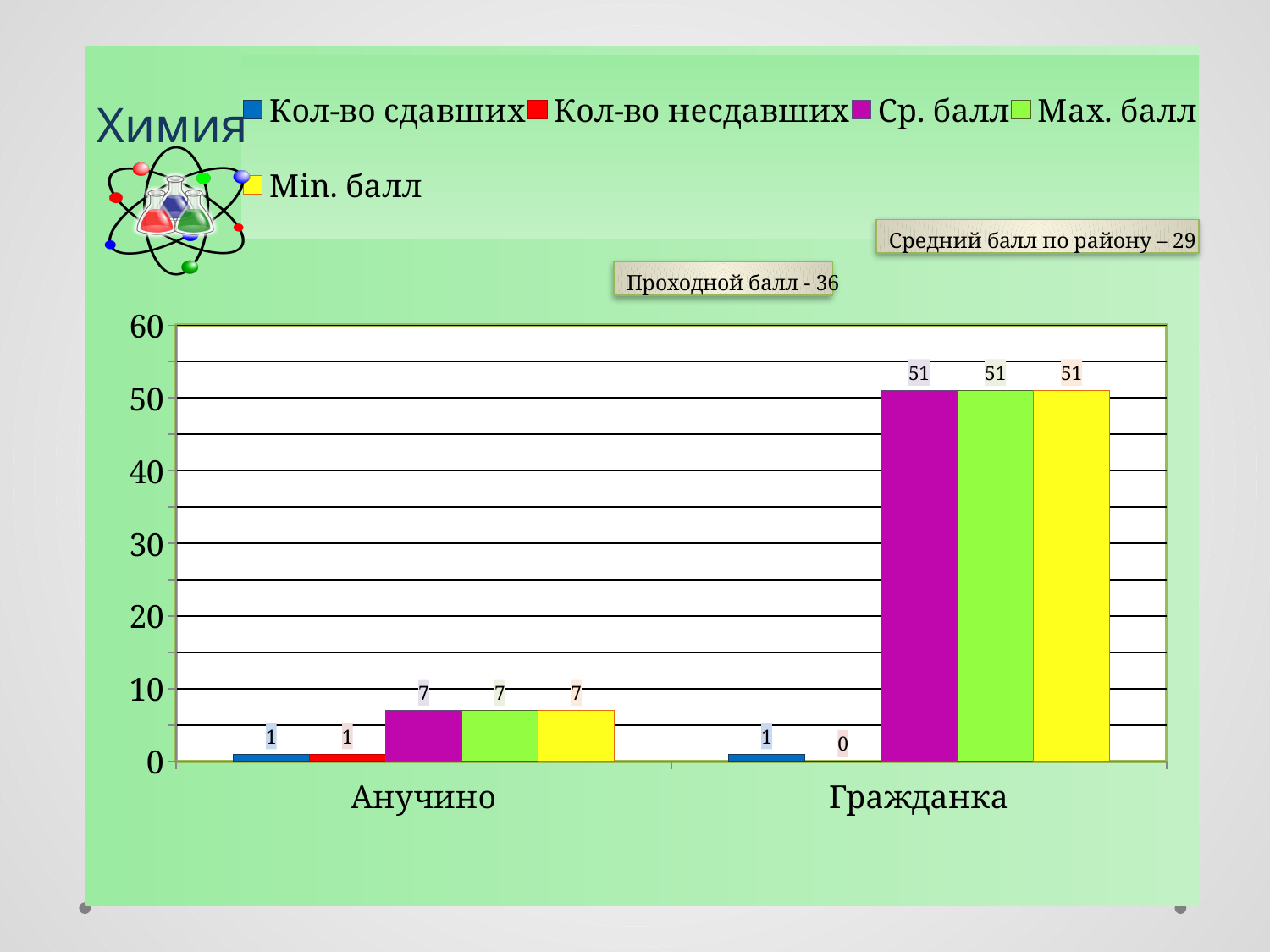
What is the value of Ср. балл for Гражданка? 51 What is the value of Max. балл for Анучино? 7 What is the difference between the Min. балл for Гражданка and the Min. балл for Анучино? 44 Which category has the higher Ср. балл, Анучино or Гражданка? Гражданка What is the Проходной балл stated on the slide? 36 Is the value of Ср. балл for Гражданка greater or less than 50? greater How many categories are shown on the x axis? 2 What is the value of Кол-во несдавших for Анучино? 1 What is the value of Кол-во несдавших for Гражданка? 0 How many series does the legend list? 5 Which series is shown in yellow in the legend? Min. балл What kind of chart is shown on the slide? bar chart